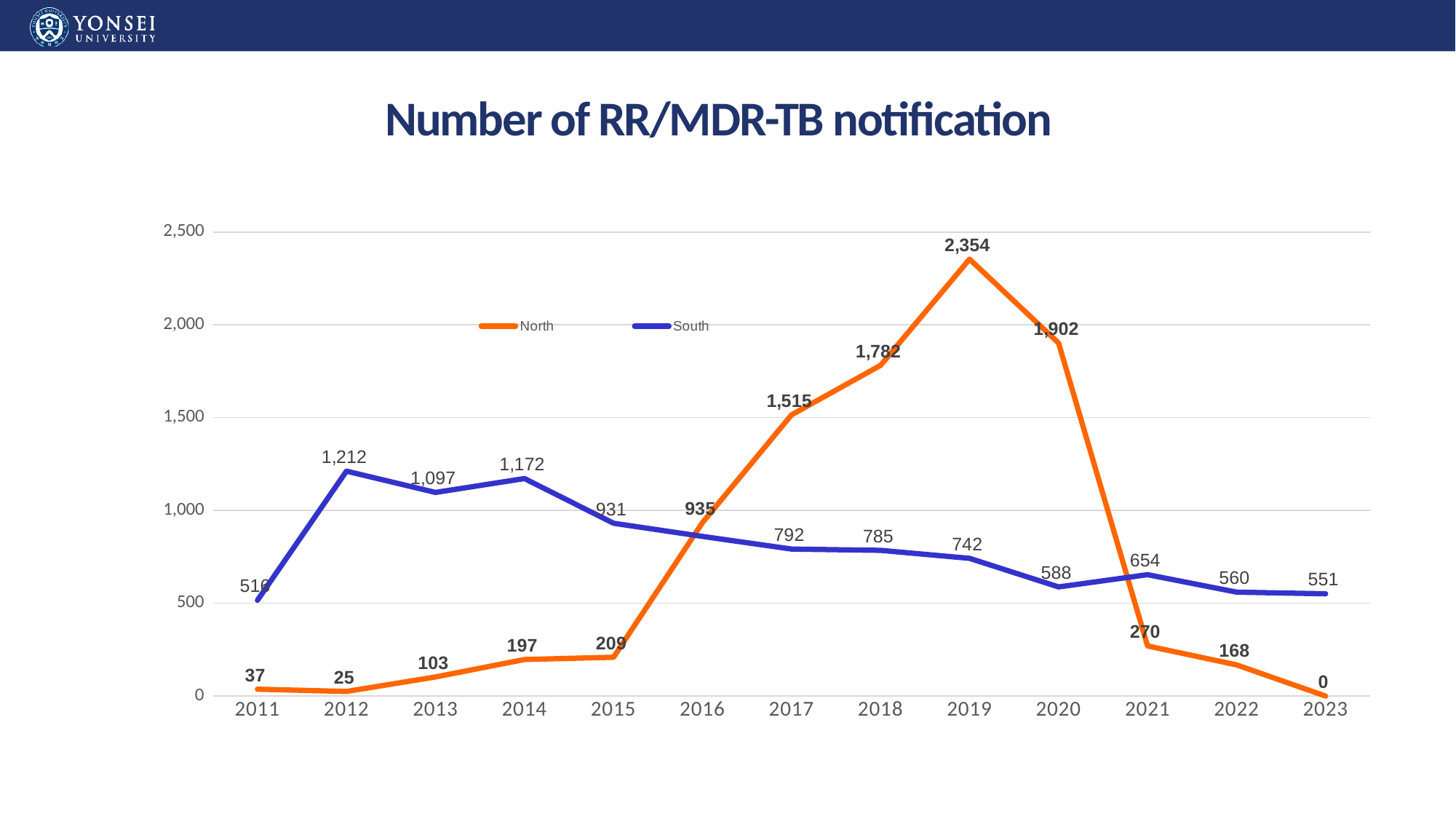
What is the difference between the North values in 2019 and 2020? 452 What kind of chart is shown on the slide? line chart What is the North value in 2019? 2,354 In which year does the North series reach its highest value? 2019 How many years are shown on the x axis? 13 What is the South value in 2023? 551 Does the South series rise or fall from 2014 to 2020? fall In 2017, which series has the larger value, North or South? North Is the South value in 2016 greater or less than 1,000? less In which year is the North value lowest? 2023 What is the South value in 2012? 1,212 How many series does the legend list? 2